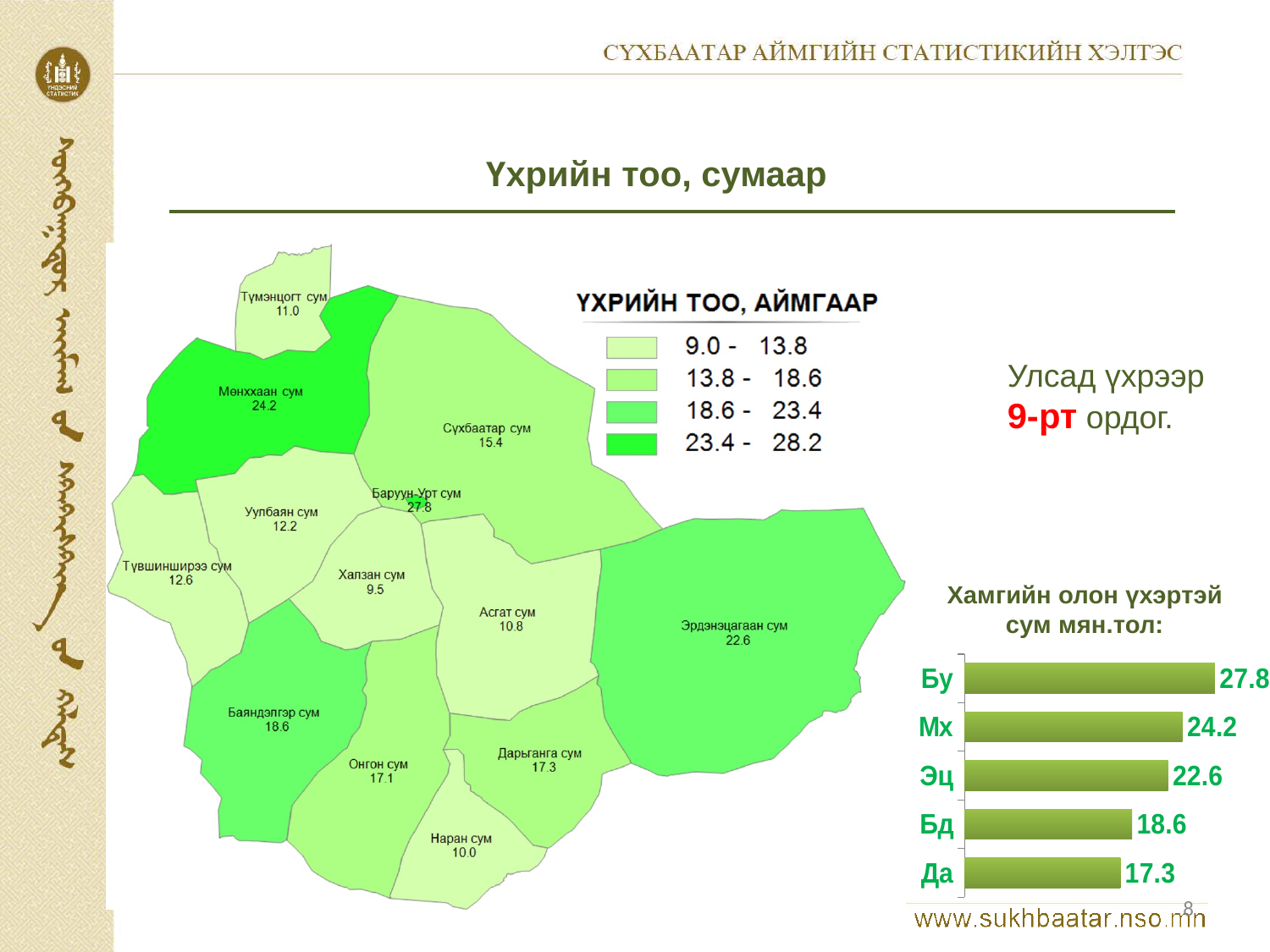
How many categories does the bar chart 'Хамгийн олон үхэртэй сум мян.тол:' show? 5 In the bar chart 'Хамгийн олон үхэртэй сум мян.тол:', what is the difference between the values for Бу and Мх? 3.6 In the bar chart 'Хамгийн олон үхэртэй сум мян.тол:', what is the value for Эц? 22.6 What kind of chart is 'Хамгийн олон үхэртэй сум мян.тол:'? Bar chart In the bar chart 'Хамгийн олон үхэртэй сум мян.тол:', which category has the lowest value? Да In the bar chart 'Хамгийн олон үхэртэй сум мян.тол:', which category has the highest value? Бу In the bar chart 'Хамгийн олон үхэртэй сум мян.тол:', what is the value for Бу? 27.8 In the bar chart 'Хамгийн олон үхэртэй сум мян.тол:', what is the difference between the values for Бд and Да? 1.3 In the bar chart 'Хамгийн олон үхэртэй сум мян.тол:', what is the value for Да? 17.3 In the bar chart 'Хамгийн олон үхэртэй сум мян.тол:', which is larger, the value for Мх or the value for Эц? Мх On the map 'Үхрийн тоо, сумаар', what value is shown for Халзан сум? 9.5 On the map 'Үхрийн тоо, сумаар', what value is shown for Эрдэнэцагаан сум? 22.6